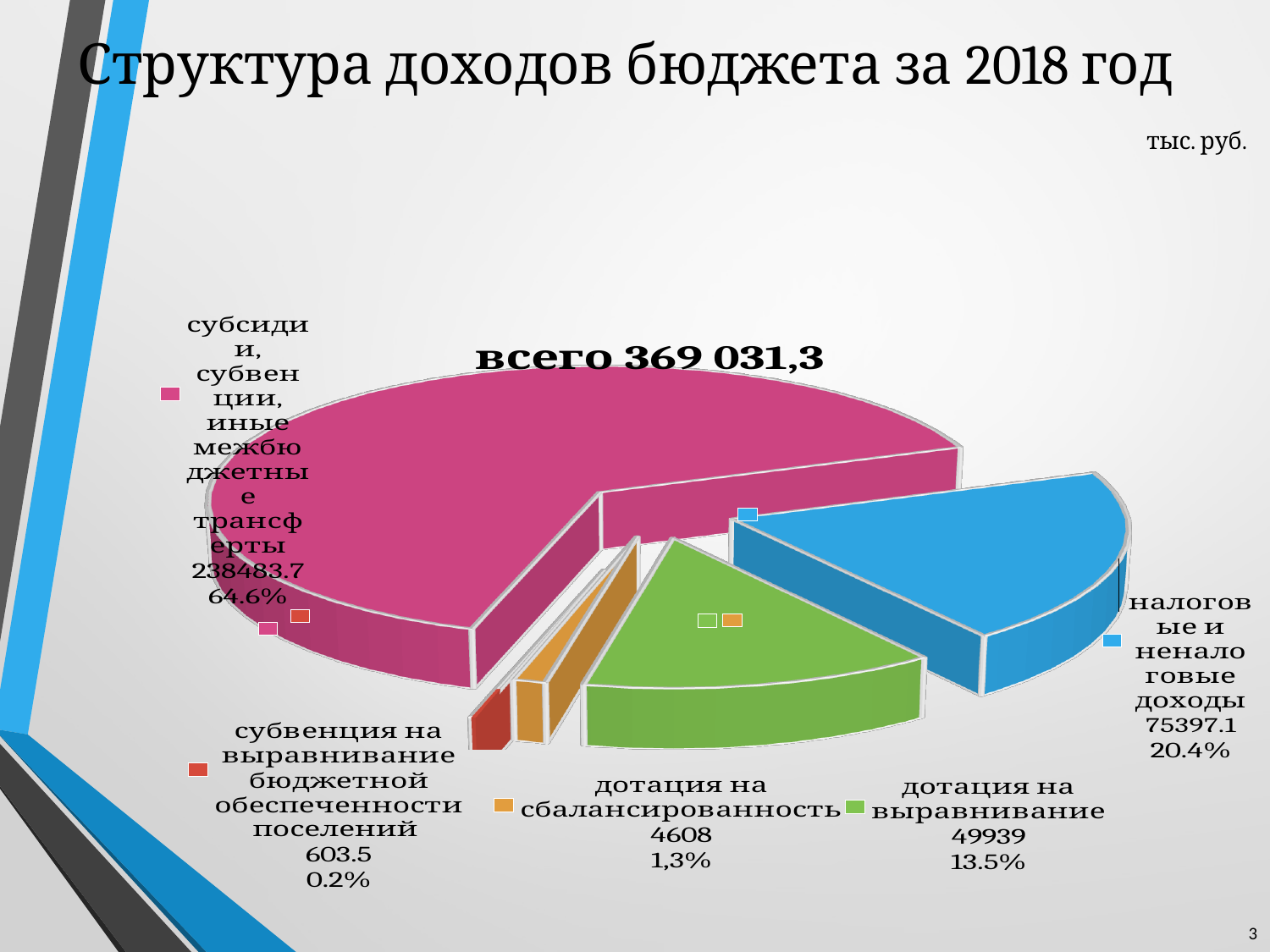
Which category has the largest slice? субсидии, субвенции, иные межбюджетные трансферты How many slices does the pie chart have? 5 What is the value for налоговые и неналоговые доходы? 75397.1 What kind of chart is shown on the slide? pie chart What is the difference between the values for дотация на выравнивание and дотация на сбалансированность? 45331 What is the value for субвенция на выравнивание бюджетной обеспеченности поселений? 603.5 Which category has the smallest slice? субвенция на выравнивание бюджетной обеспеченности поселений What share of the pie is дотация на сбалансированность? 1,3% What is the chart's title? всего 369 031,3 What is the value for дотация на выравнивание? 49939 What share of the pie is налоговые и неналоговые доходы? 20.4% Which is larger: дотация на выравнивание or дотация на сбалансированность? дотация на выравнивание